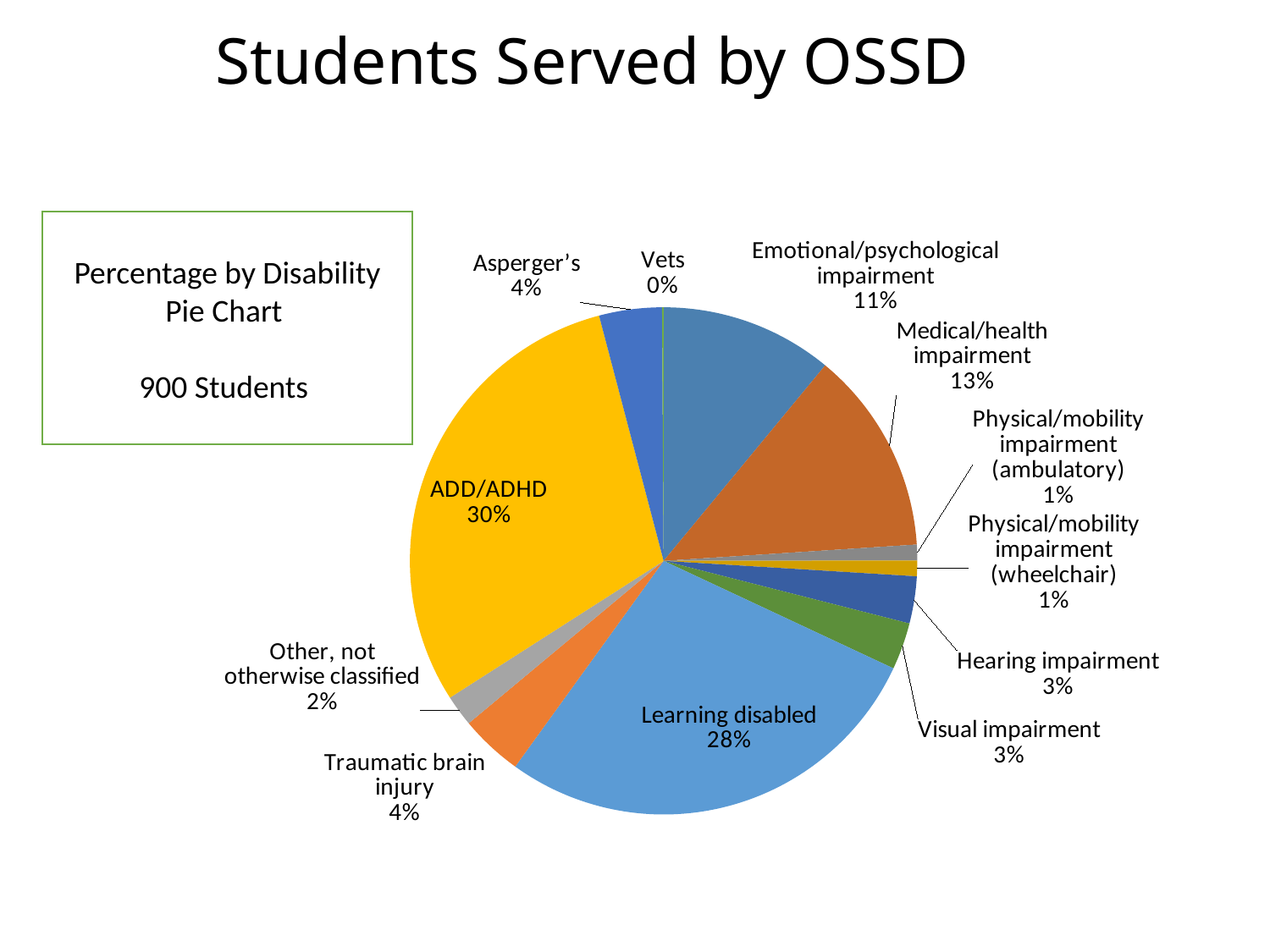
How many disability categories are shown in the pie chart? 12 What share of the pie is Medical/health impairment? 13% What type of chart is shown on the slide? Pie chart What percentage is shown for Emotional/psychological impairment? 11% According to the text box on the slide, how many students does the pie chart represent? 900 Students Which disability category has the largest share of the pie? ADD/ADHD Which category has the smallest share of the pie? Vets What percentage of students served by OSSD have ADD/ADHD? 30% Which is larger, the share for Medical/health impairment or the share for Emotional/psychological impairment? Medical/health impairment What percentage is shown for Traumatic brain injury? 4% What is the difference in percentage points between ADD/ADHD and Learning disabled? 2 What percentage of students are classified as Learning disabled? 28%